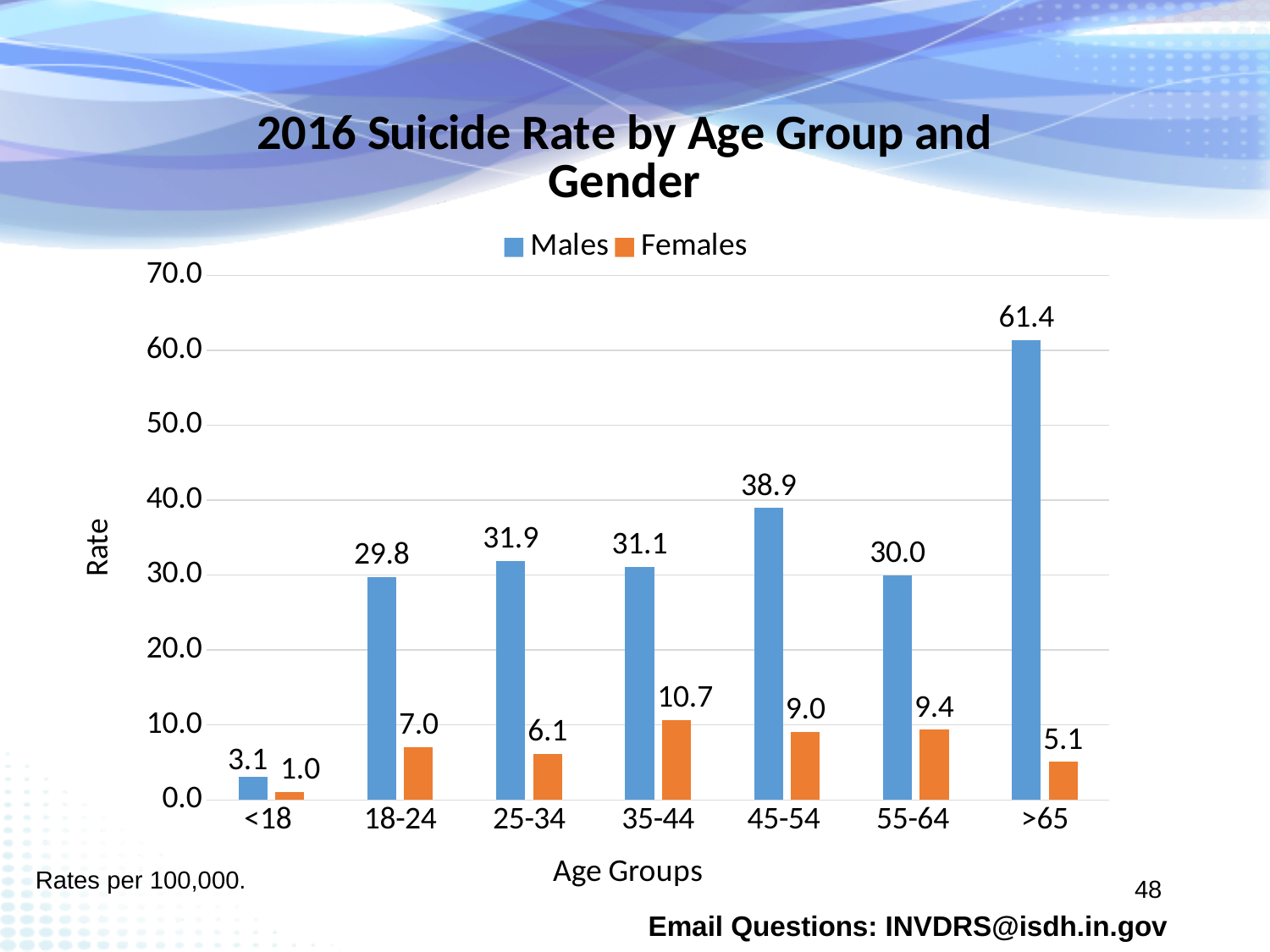
What is the difference between the male and female suicide rates for the 45-54 age group? 29.9 Which is larger, the female rate for 18-24 or the female rate for 25-34? 18-24 What is the suicide rate for females aged 35-44? 10.7 How many series does the legend list? 2 How many age groups are shown on the x axis? 7 Which age group has the lowest female suicide rate? <18 What is the title of the chart? 2016 Suicide Rate by Age Group and Gender Which colour represents Females in the chart? orange Which age group has the highest male suicide rate? >65 What is the suicide rate for males aged >65? 61.4 What kind of chart is shown on the slide? bar chart Is the male suicide rate for the 45-54 age group greater or less than 40.0? less